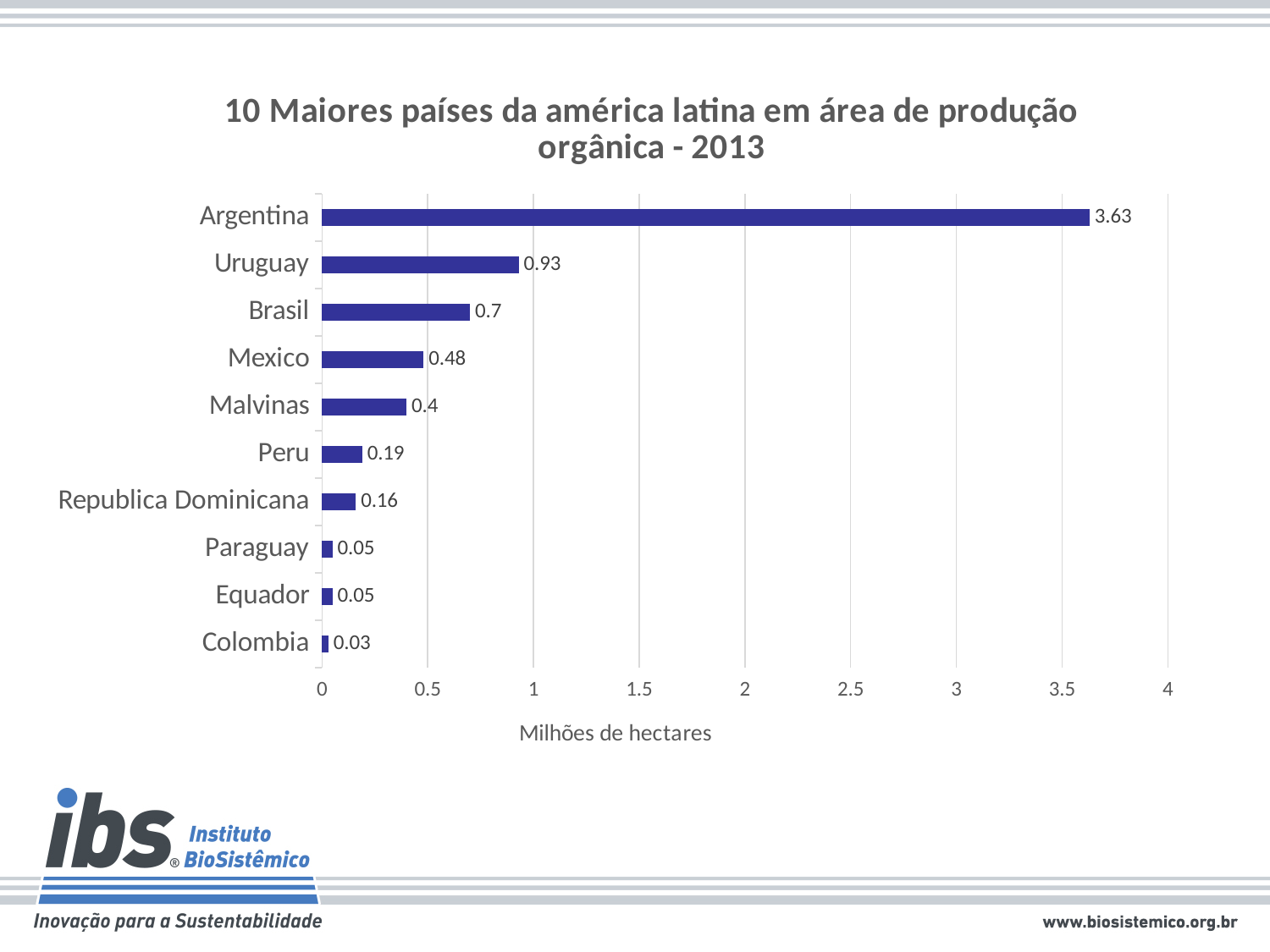
What is the difference between the values for Mexico and Malvinas? 0.08 What is the difference between the values for Argentina and Uruguay? 2.7 How many countries are shown in the chart? 10 What is the value for Argentina? 3.63 Which country has the lowest value? Colombia Which is larger, the value for Uruguay or the value for Brasil? Uruguay What is the value for Brasil? 0.7 Which country has the highest value? Argentina What is the value for Republica Dominicana? 0.16 What kind of chart is shown on the slide? bar chart Is the value for Argentina greater or less than 3.5? greater What is the label of the horizontal axis? Milhões de hectares